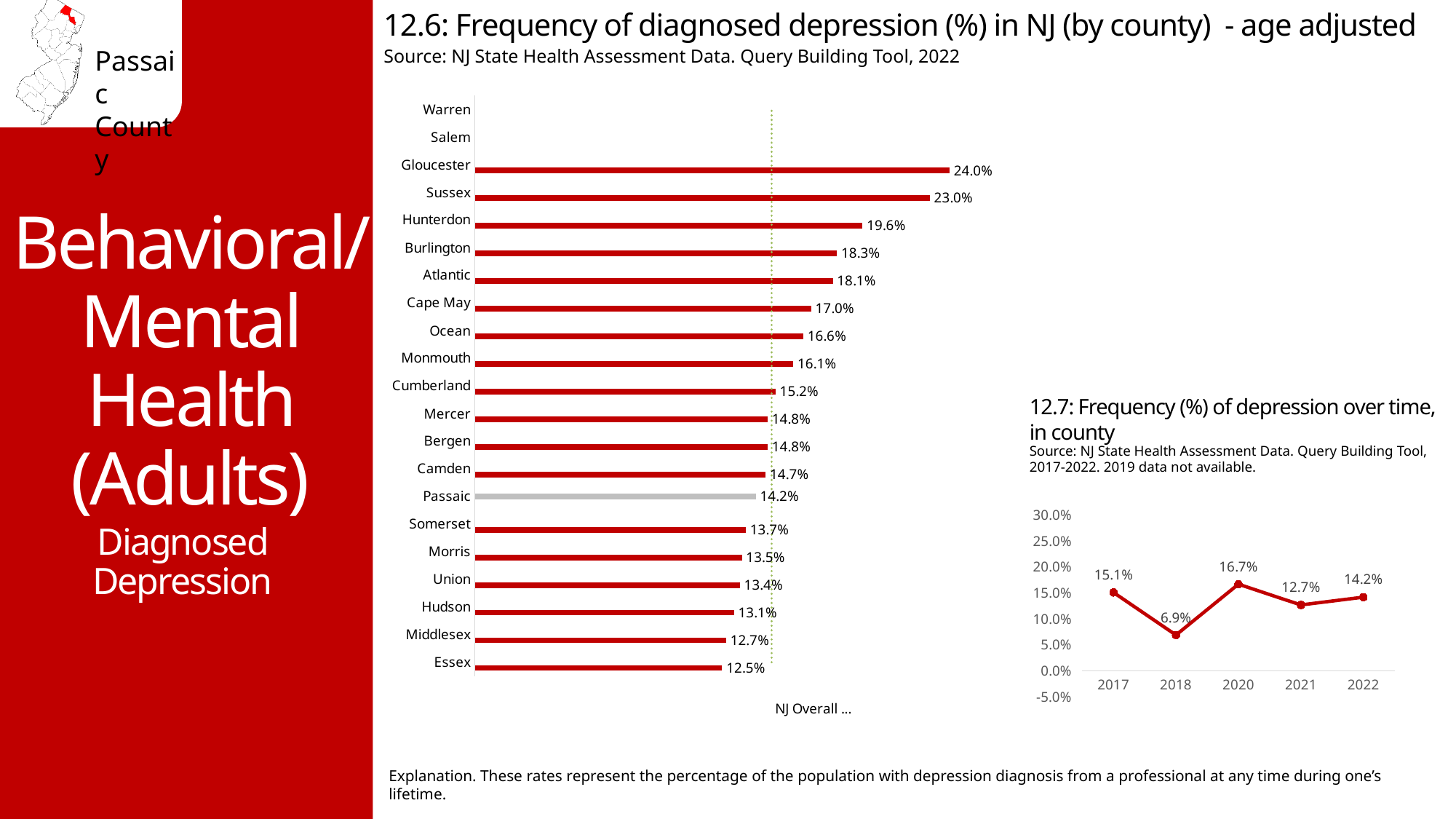
What kind of chart is chart 12.6? Bar chart In chart 12.6, which county has the highest frequency of diagnosed depression? Gloucester In chart 12.6, what is the value for Gloucester? 24.0% In chart 12.7, which year has the lowest frequency of depression? 2018 In chart 12.7, what is the frequency of depression in 2018? 6.9% In chart 12.6, what is the frequency of diagnosed depression for Passaic? 14.2% In chart 12.7, which year has the highest frequency of depression? 2020 In chart 12.7, how many years are plotted? 5 In chart 12.6, what is the value for Middlesex? 12.7% In chart 12.7, what is the difference between the 2020 and 2021 values? 4.0% In chart 12.6, which is larger, the value for Hunterdon or the value for Burlington? Hunterdon In chart 12.6, what is the difference between the values for Sussex and Essex? 10.5%